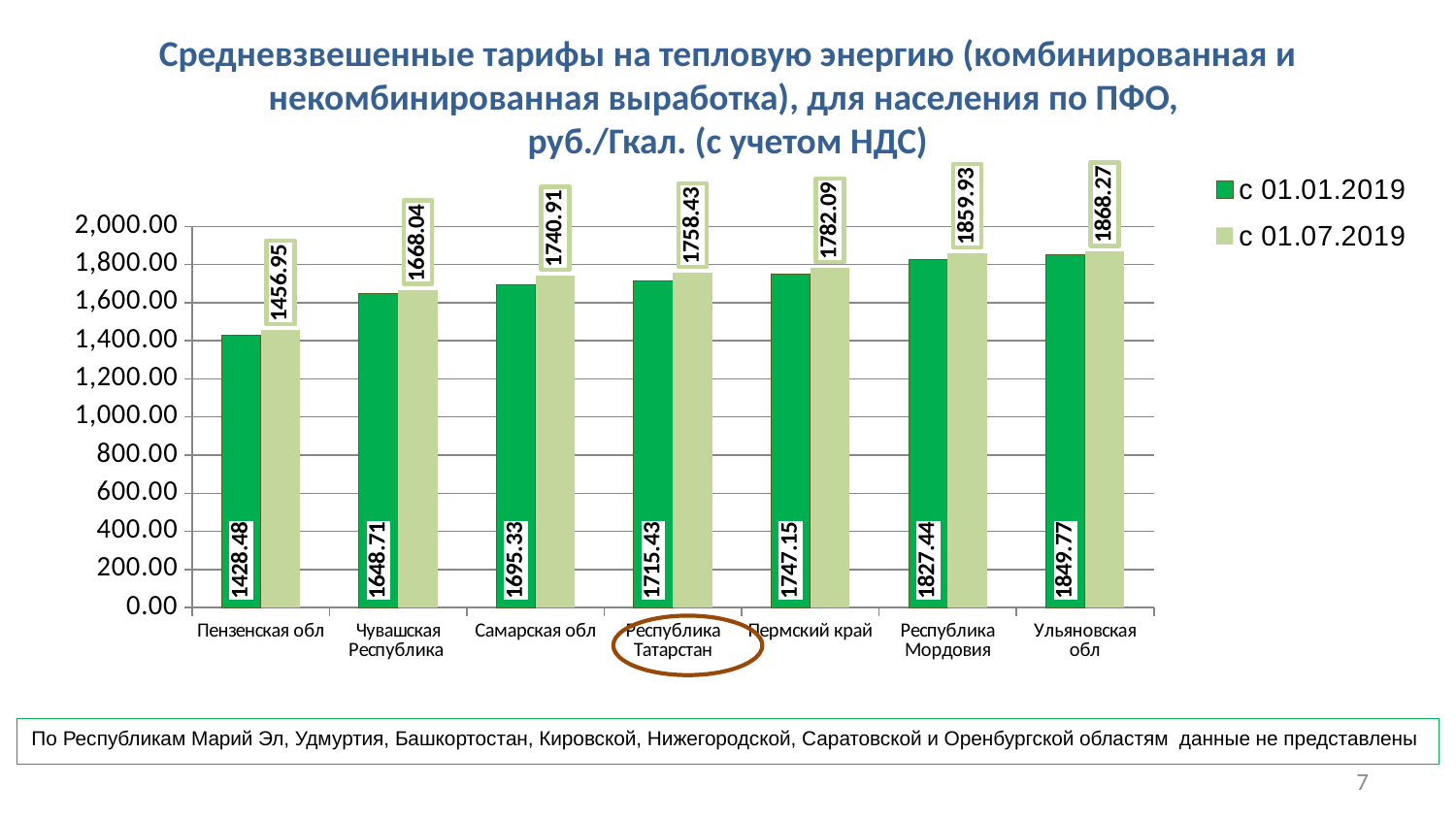
What is the difference between the с 01.07.2019 and с 01.01.2019 values for Республика Татарстан? 43.00 How many series does the legend list? 2 Which region on the x axis is circled on the slide? Республика Татарстан What is the value for Республика Татарстан in the series с 01.07.2019? 1758.43 Which is larger: the с 01.01.2019 value for Республика Мордовия or the с 01.01.2019 value for Ульяновская обл? Ульяновская обл Which region has the highest value in the series с 01.07.2019? Ульяновская обл What is the value for Самарская обл in the series с 01.07.2019? 1740.91 Do the values in the series с 01.01.2019 rise or fall from left to right along the x axis? rise What type of chart is shown on the slide? bar chart Which region has the lowest value in the series с 01.01.2019? Пензенская обл What is the value for Пермский край in the series с 01.01.2019? 1747.15 How many regions are shown on the x axis? 7